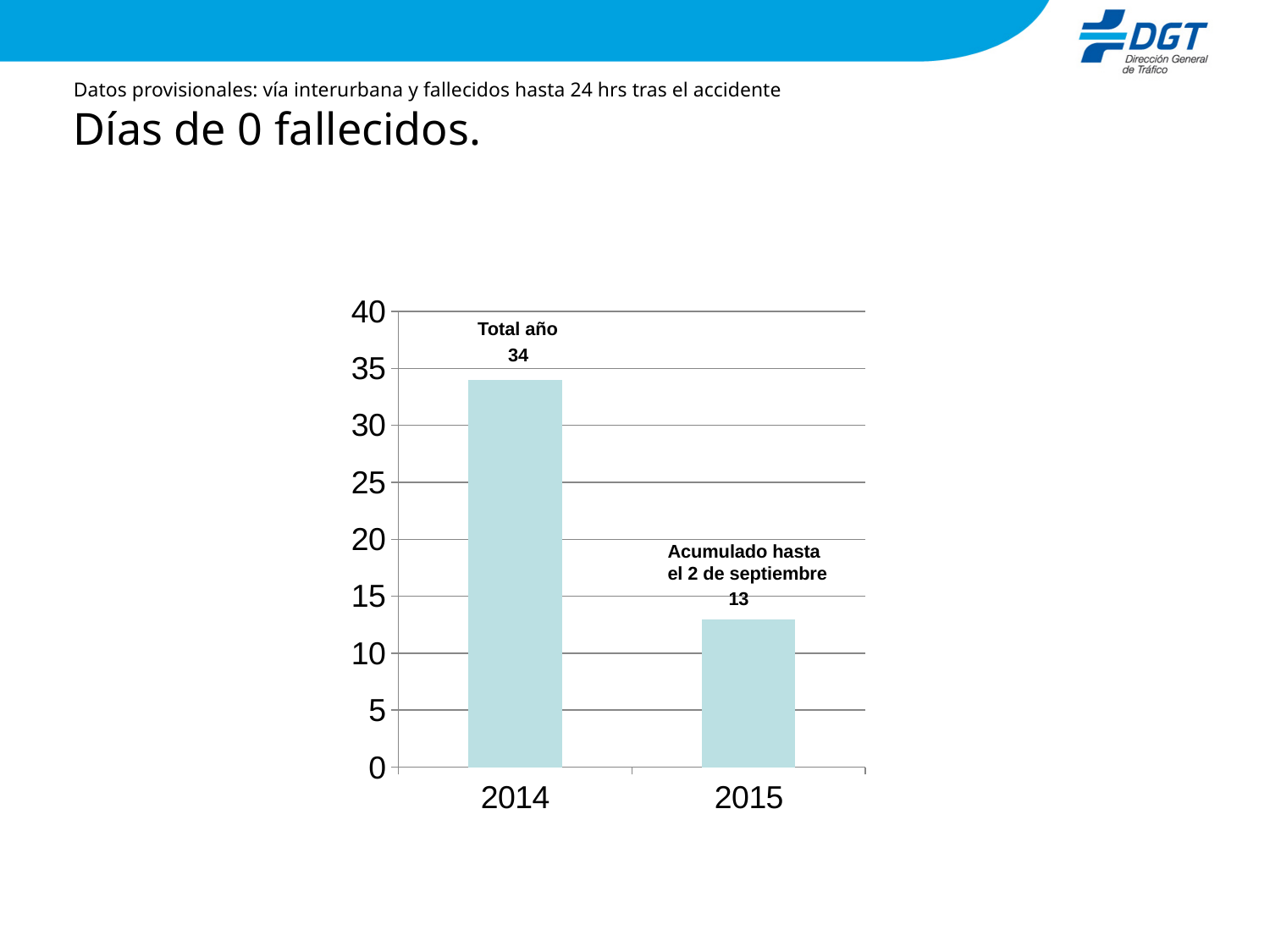
What is the value for 2014? 34 What kind of chart is shown on the slide? bar chart Which year has the lowest value? 2015 Which year has the highest value? 2014 What is the title of the slide? Días de 0 fallecidos. What is the value for 2015? 13 How many bars are shown in the chart? 2 Do the values rise or fall from 2014 to 2015? fall Is the value for 2015 greater or less than 15? less What is the difference between the values for 2014 and 2015? 21 Which is larger, the value for 2014 or the value for 2015? 2014 Is the value for 2014 greater or less than 30? greater